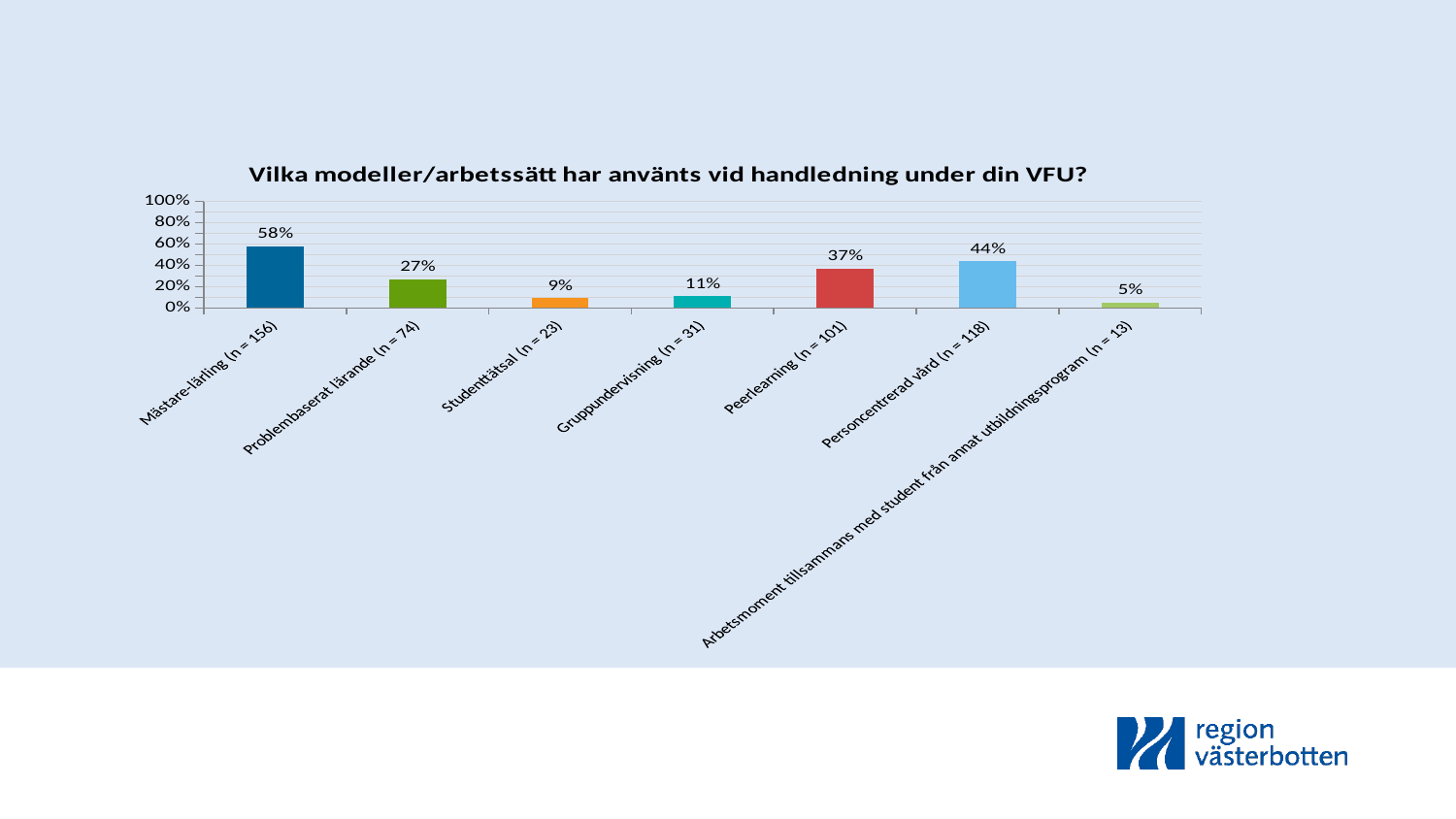
What kind of chart is shown on the slide? bar chart What is the value for Personcentrerad vård (n = 118)? 44% What is the value for Mästare-lärling (n = 156)? 58% How many categories are shown in the chart? 7 Which is larger, the value for Problembaserat lärande (n = 74) or the value for Peerlearning (n = 101)? Peerlearning (n = 101) Is the value for Gruppundervisning (n = 31) greater or less than 20%? less What is the title of the chart? Vilka modeller/arbetssätt har använts vid handledning under din VFU? Which category has the lowest value? Arbetsmoment tillsammans med student från annat utbildningsprogram (n = 13) Which category has the highest value? Mästare-lärling (n = 156) What is the value for Peerlearning (n = 101)? 37% What is the difference between the values for Mästare-lärling (n = 156) and Personcentrerad vård (n = 118)? 14% What is the value for Studenttätsal (n = 23)? 9%